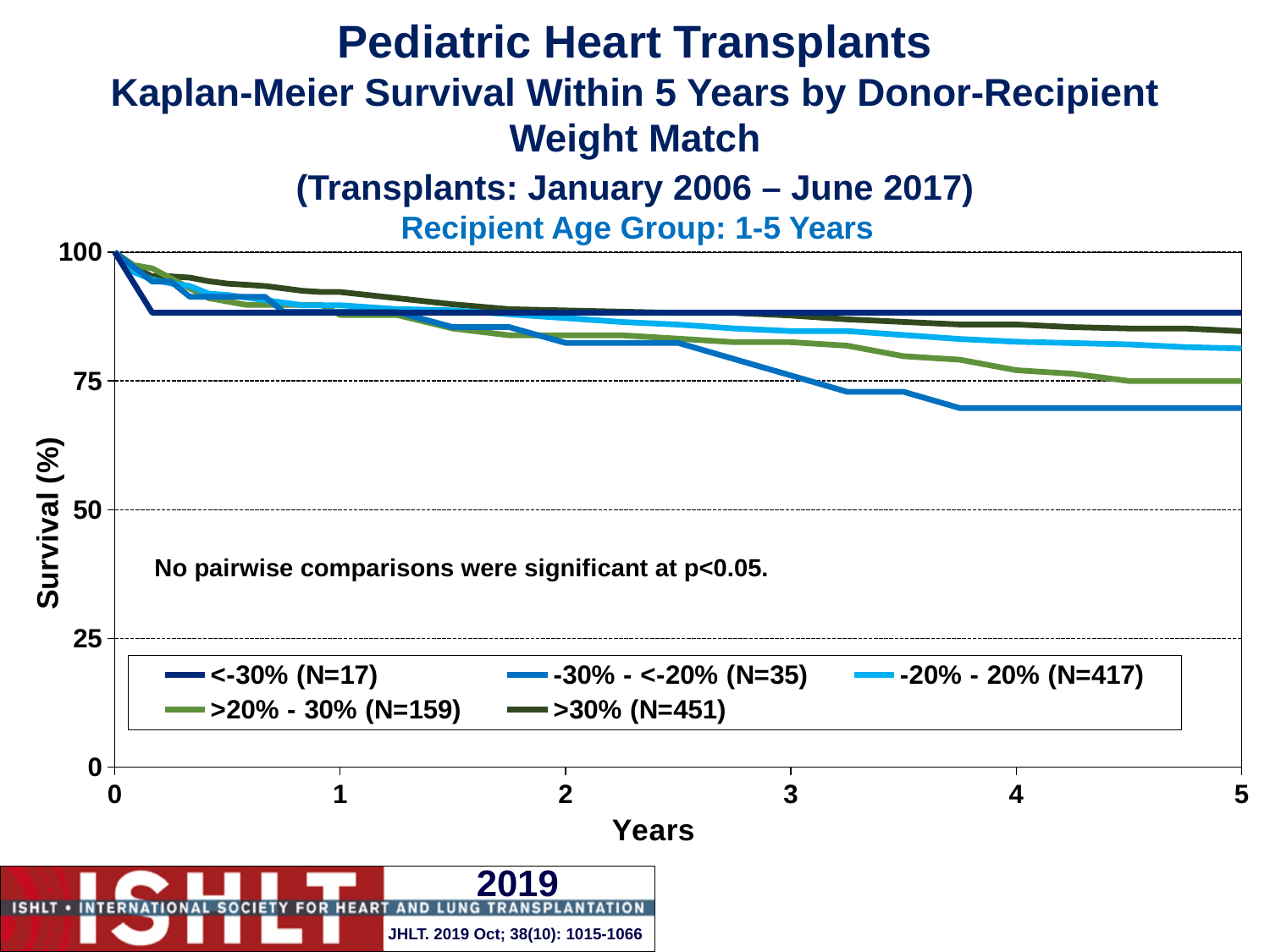
Is the survival for the >30% group at 5 years greater or less than 75? greater What is the N for the <-30% weight match group shown in the legend? 17 What is the N for the >30% weight match group shown in the legend? 451 Which recipient age group does the chart cover? 1-5 Years Do the survival curves rise or fall as years increase? fall Is the survival for the -30% - <-20% group at 5 years greater or less than 75? less Which weight match group has the lowest survival at 5 years? -30% - <-20% (N=35) How many series does the legend list? 5 What is the N for the -20% - 20% weight match group shown in the legend? 417 What kind of chart is shown on the slide? Line chart What is the label of the x axis? Years Is the survival for the -20% - 20% group at 5 years greater or less than 75? greater